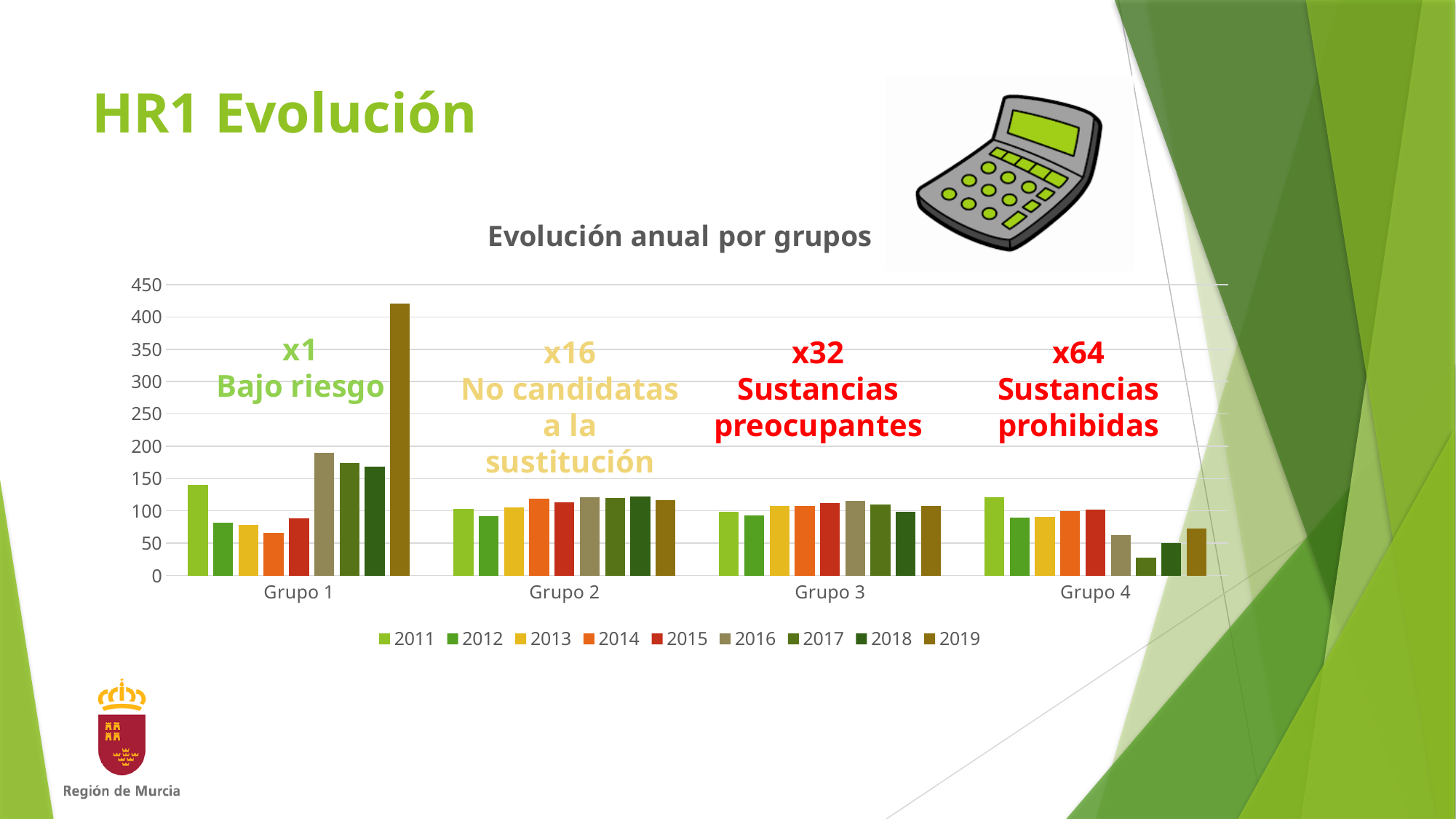
What is the title of the chart? Evolución anual por grupos What kind of chart is shown on the slide? bar chart Is the value for 2019 in Grupo 1 greater or less than 400? greater How many series does the chart's legend list? 9 How many groups (categories) are shown on the x axis of the chart? 4 Which is larger in Grupo 1: the value for 2016 or the value for 2019? 2019 Is the value for 2017 in Grupo 4 greater or less than 50? less Is the value for 2016 in Grupo 1 greater or less than 200? less Which year has the lowest bar in Grupo 4? 2017 Which year has the highest bar in Grupo 1? 2019 Which year is the first entry in the chart's legend? 2011 Which year has the highest bar in Grupo 4? 2011